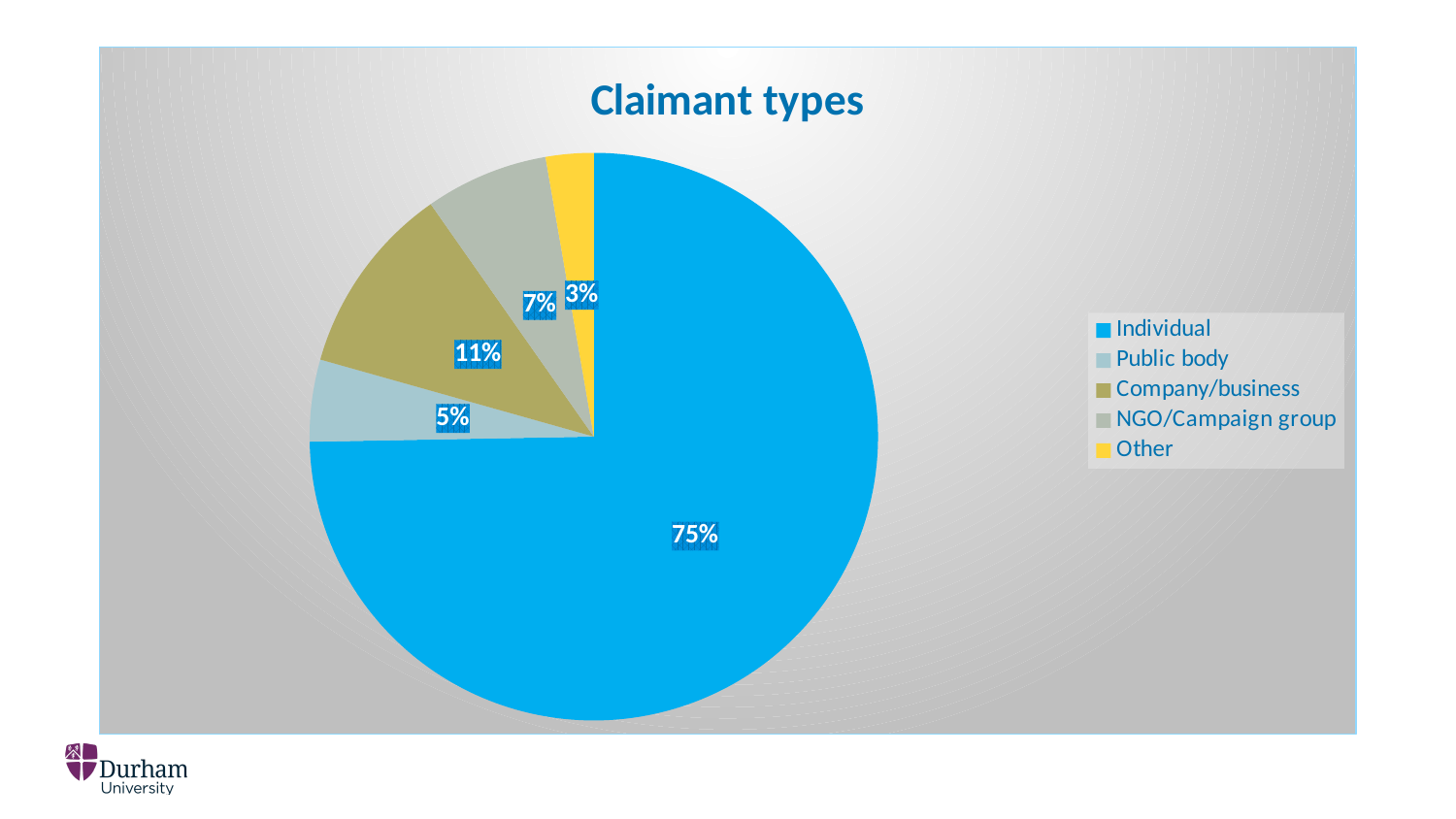
What kind of chart is shown on the slide? Pie chart What is the difference between the Individual and Company/business shares? 64% What is the value for NGO/Campaign group? 7% What is the title of the chart? Claimant types What is the value for Company/business? 11% What share of the pie does Individual account for? 75% How many categories does the pie chart show? 5 Which claimant type has the smallest share? Other Which is larger, Public body or NGO/Campaign group? NGO/Campaign group Which claimant type has the largest share? Individual What is the value for Other? 3% What is the value for Public body? 5%